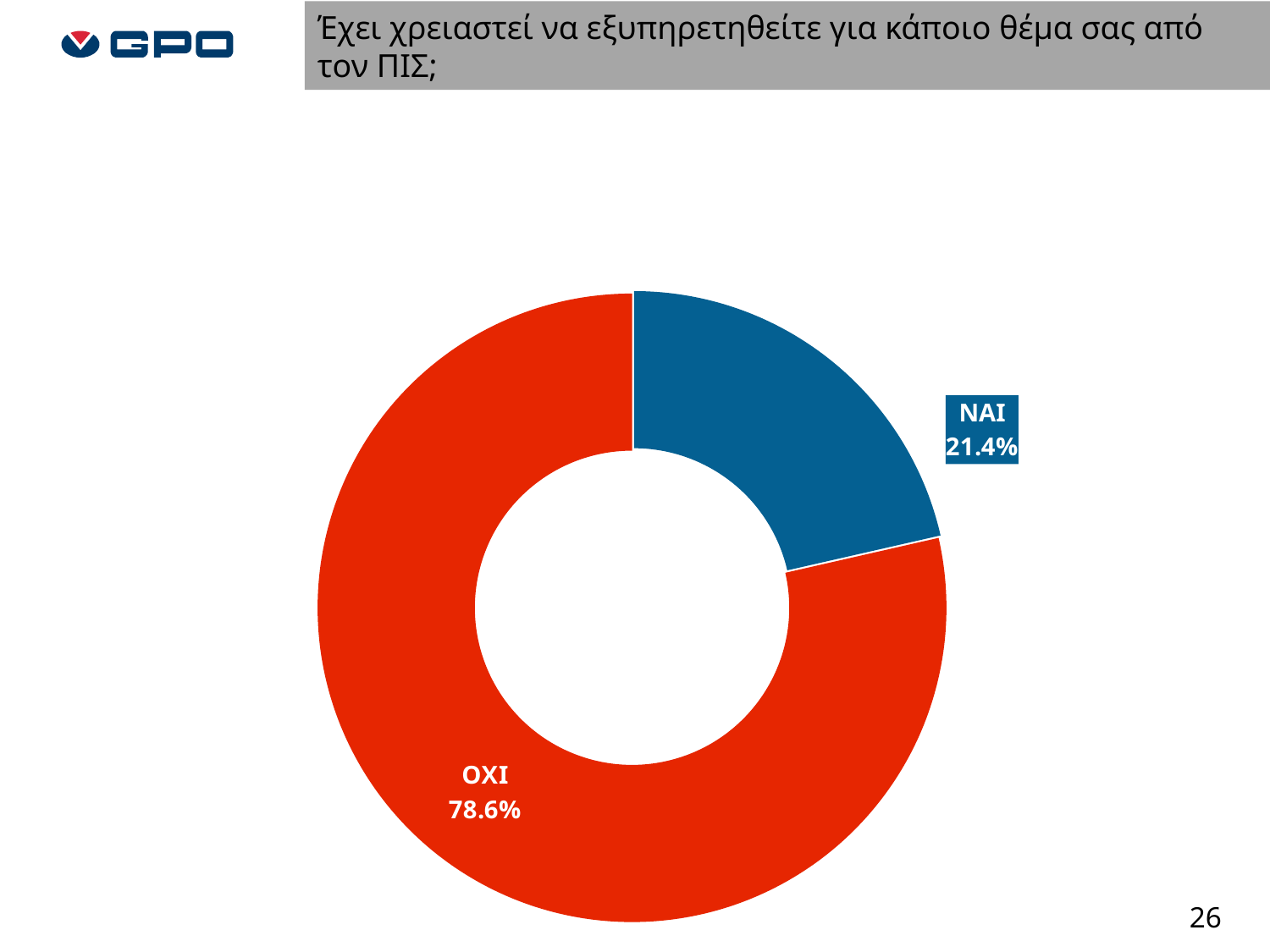
Which response has the smallest share of the chart? ΝΑΙ Which response has the largest share of the chart? ΟΧΙ Which is larger, the share for ΝΑΙ or the share for ΟΧΙ? ΟΧΙ What is the difference in percentage points between ΟΧΙ and ΝΑΙ? 57.2 What colour is the ΟΧΙ slice? Red What kind of chart is shown on the slide? Pie chart (doughnut) How many categories are shown in the chart? 2 What share of the pie does the ΟΧΙ slice represent? 78.6% What percentage of respondents answered ΝΑΙ? 21.4% What percentage of respondents answered ΟΧΙ? 78.6% What colour is the ΝΑΙ slice? Blue